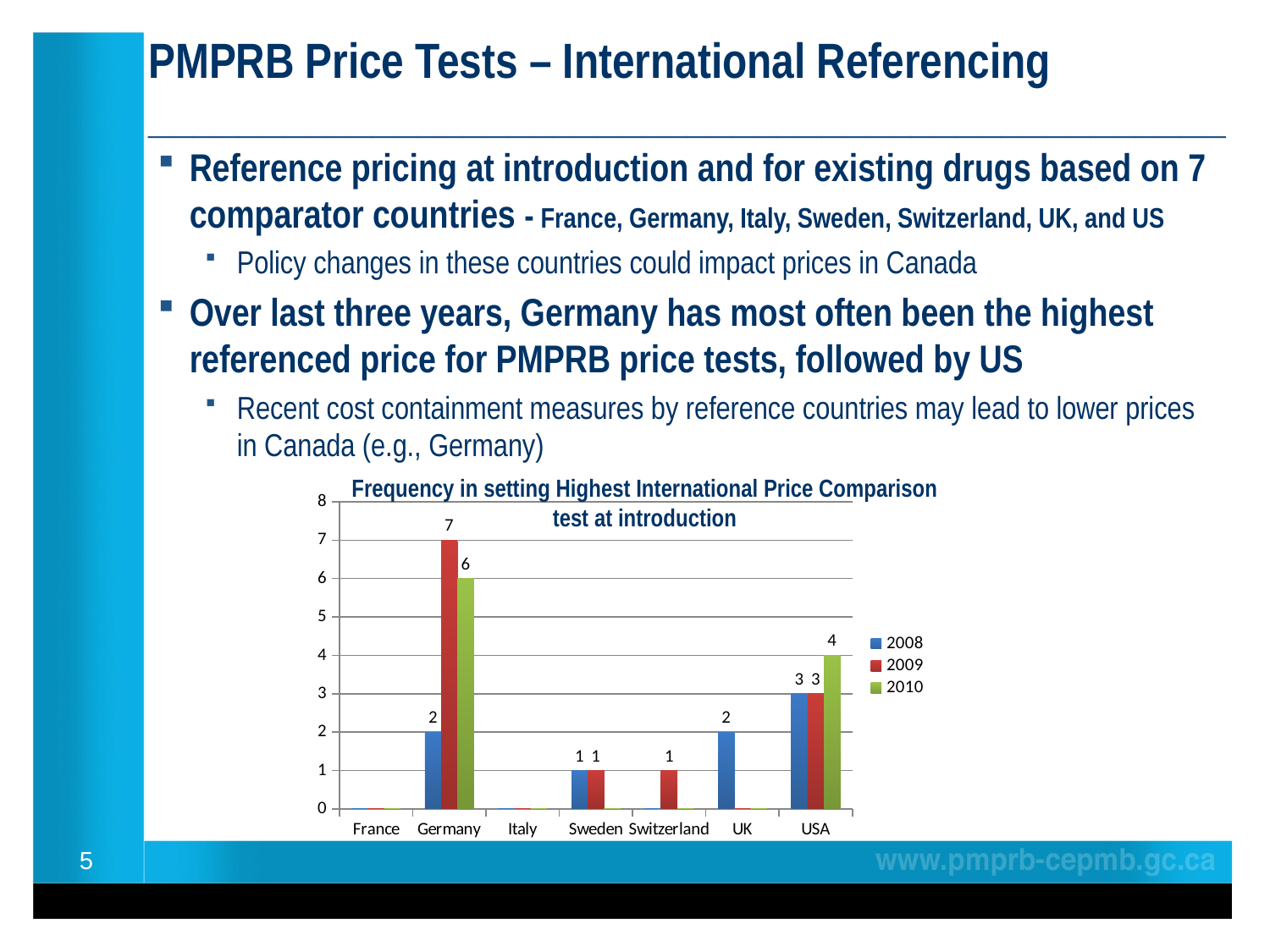
What is the value for USA in 2010? 4 What is the value for UK in 2008? 2 What is the difference between the 2009 and 2010 values for Germany? 1 What kind of chart is shown on the slide? Bar chart Which country has the highest value for the 2009 series? Germany How many countries are shown on the x axis? 7 What is the value for Germany in 2009? 7 How many series does the legend list? 3 Which country has the highest value for the 2010 series? Germany Which is larger, the 2008 value for Germany or the 2008 value for USA? USA What is the difference between the 2009 values for Germany and USA? 4 Which series is shown in green in the legend? 2010